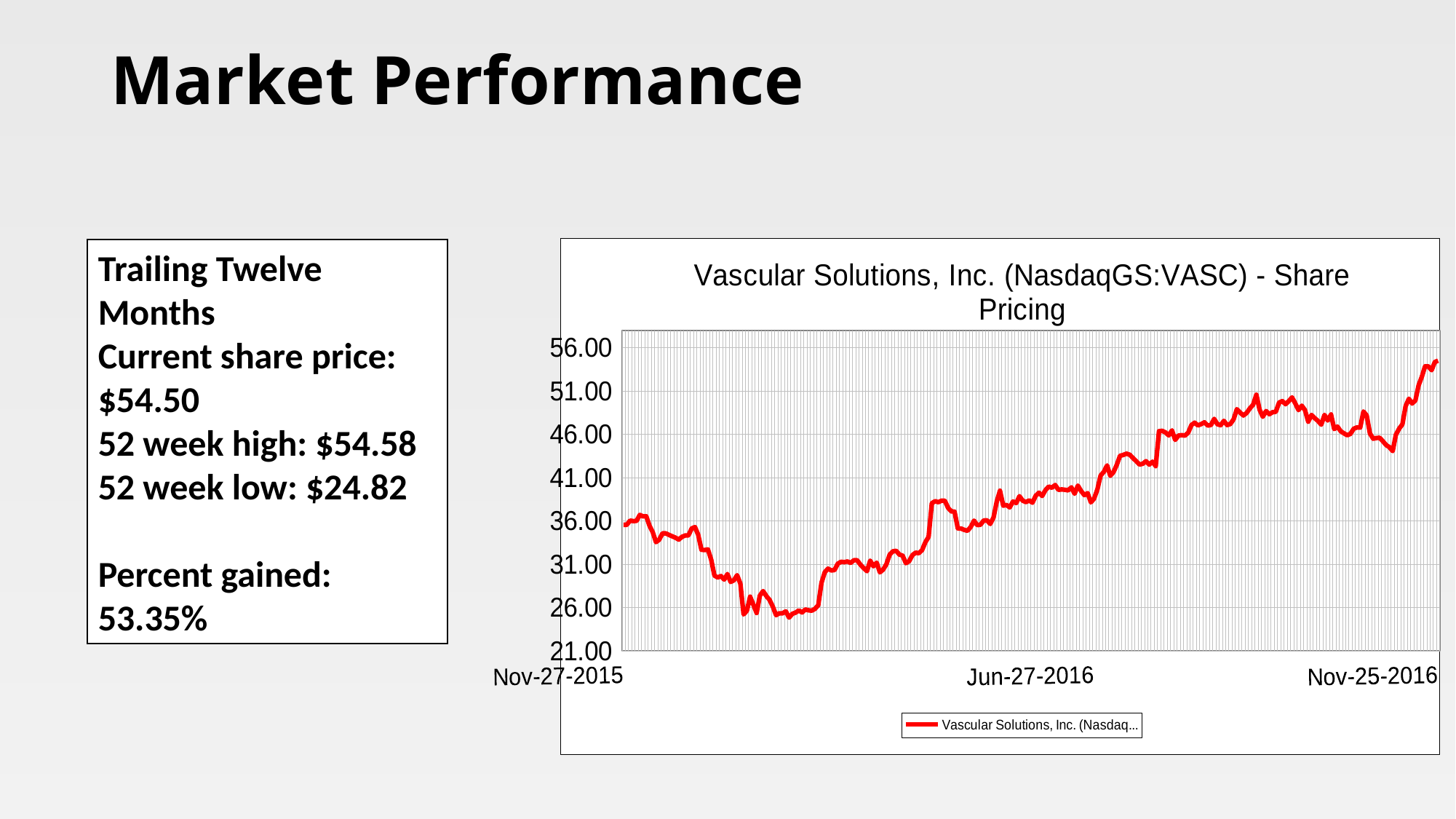
Is the share price at Nov-27-2015 greater or less than 41.00? less What colour is the line plotted on the chart? red Is the share price at Nov-27-2015 greater or less than 31.00? greater How many series does the chart's legend list? 1 Is the share price at Jun-27-2016 greater or less than 46.00? less What is the title of the chart? Vascular Solutions, Inc. (NasdaqGS:VASC) - Share Pricing What is the lowest value shown on the chart's vertical axis? 21.00 What kind of chart is shown on the slide? line chart Which is larger, the share price at Nov-25-2016 or at Nov-27-2015? Nov-25-2016 Overall, does the share price rise or fall from Nov-27-2015 to Nov-25-2016? rise